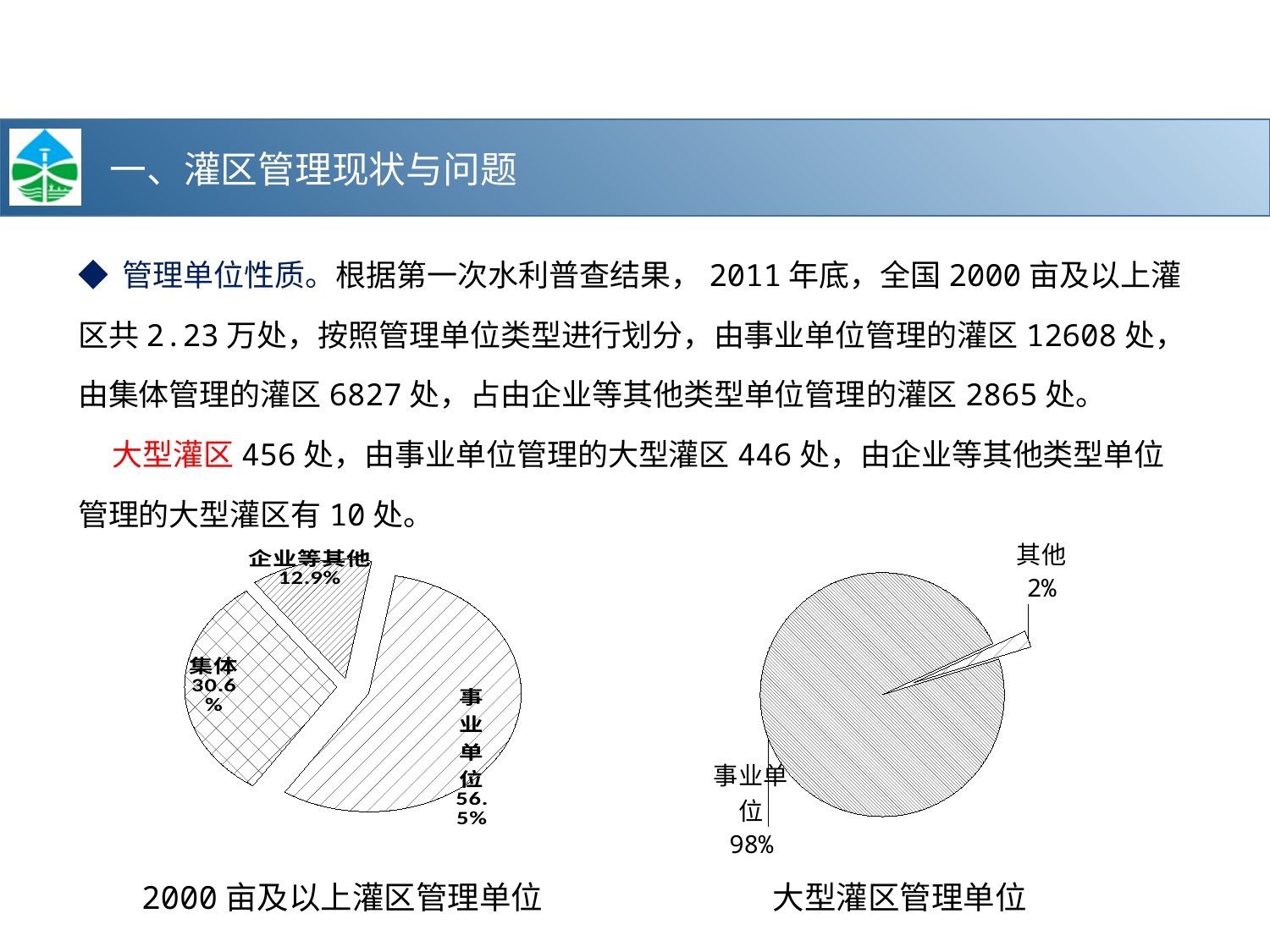
In the left pie chart (2000亩及以上灌区管理单位), what share is labelled for 企业等其他? 12.9% In the left pie chart (2000亩及以上灌区管理单位), what share is labelled for 事业单位? 56.5% In the left pie chart (2000亩及以上灌区管理单位), which category has the largest slice? 事业单位 In the left pie chart (2000亩及以上灌区管理单位), which category has the smallest slice? 企业等其他 In the left pie chart (2000亩及以上灌区管理单位), how many slices are there? 3 In the left pie chart (2000亩及以上灌区管理单位), what is the difference in percentage points between 事业单位 and 集体? 25.9 What is the title shown under the left chart? 2000亩及以上灌区管理单位 In the right pie chart (大型灌区管理单位), what share is labelled for 事业单位? 98% In the right pie chart (大型灌区管理单位), how many slices are there? 2 In the left pie chart (2000亩及以上灌区管理单位), what share is labelled for 集体? 30.6% In the right pie chart (大型灌区管理单位), what share is labelled for 其他? 2% What type of chart is the right chart (大型灌区管理单位)? pie chart